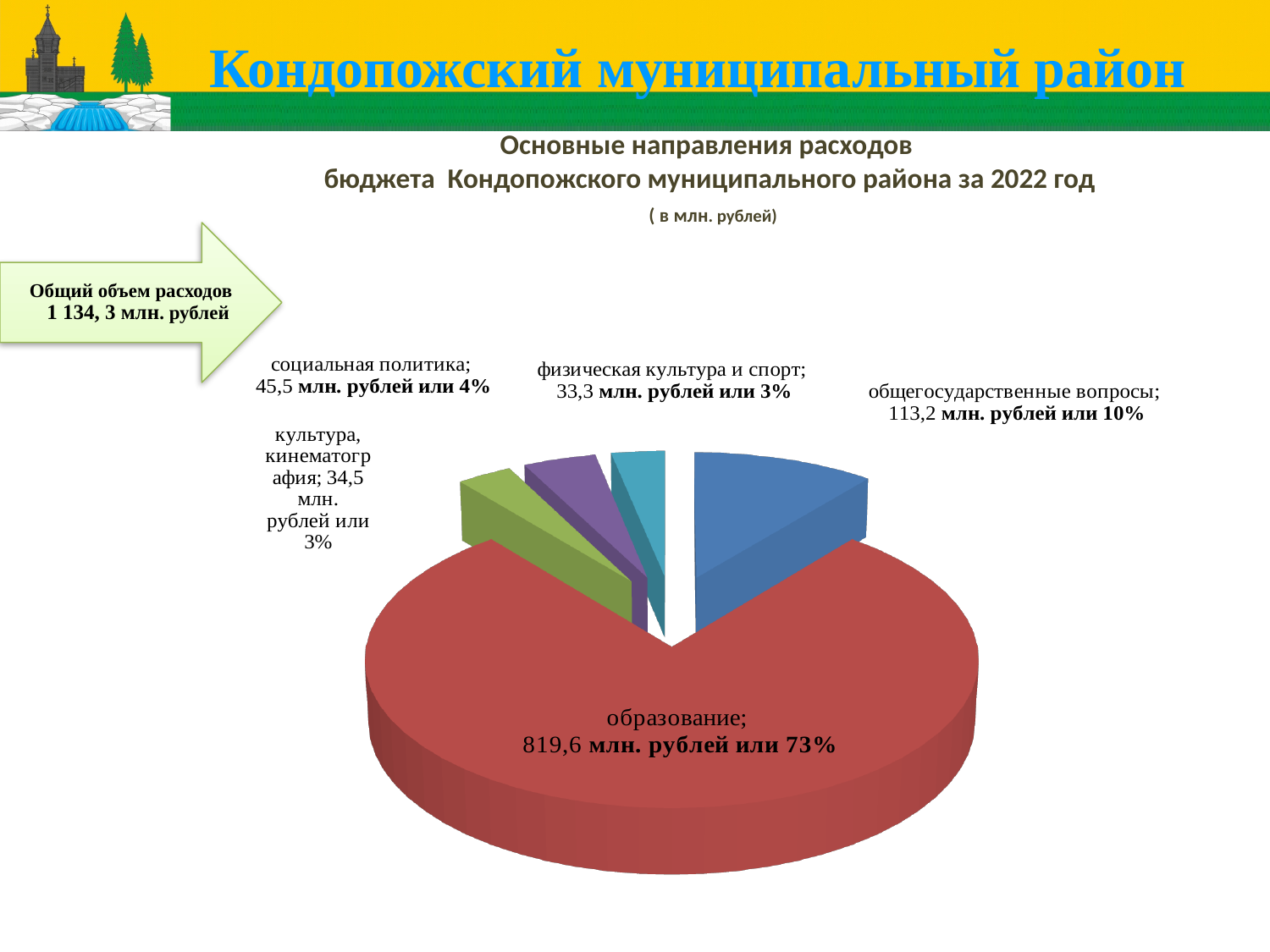
How many slices does the pie chart have? 5 What kind of chart is shown on the slide? pie chart Which is larger: социальная политика or культура, кинематография? социальная политика What is the value for общегосударственные вопросы? 113,2 млн. рублей Which category has the smallest slice of the pie? физическая культура и спорт What share of the pie does социальная политика take? 4% Which category has the largest slice of the pie? образование What is the value for физическая культура и спорт? 33,3 млн. рублей What is the value for образование in the pie chart? 819,6 млн. рублей What is the difference between образование and общегосударственные вопросы in млн. рублей? 706,4 What share of the pie does образование take? 73% What total expenditure volume is stated in the arrow on the slide? 1 134, 3 млн. рублей